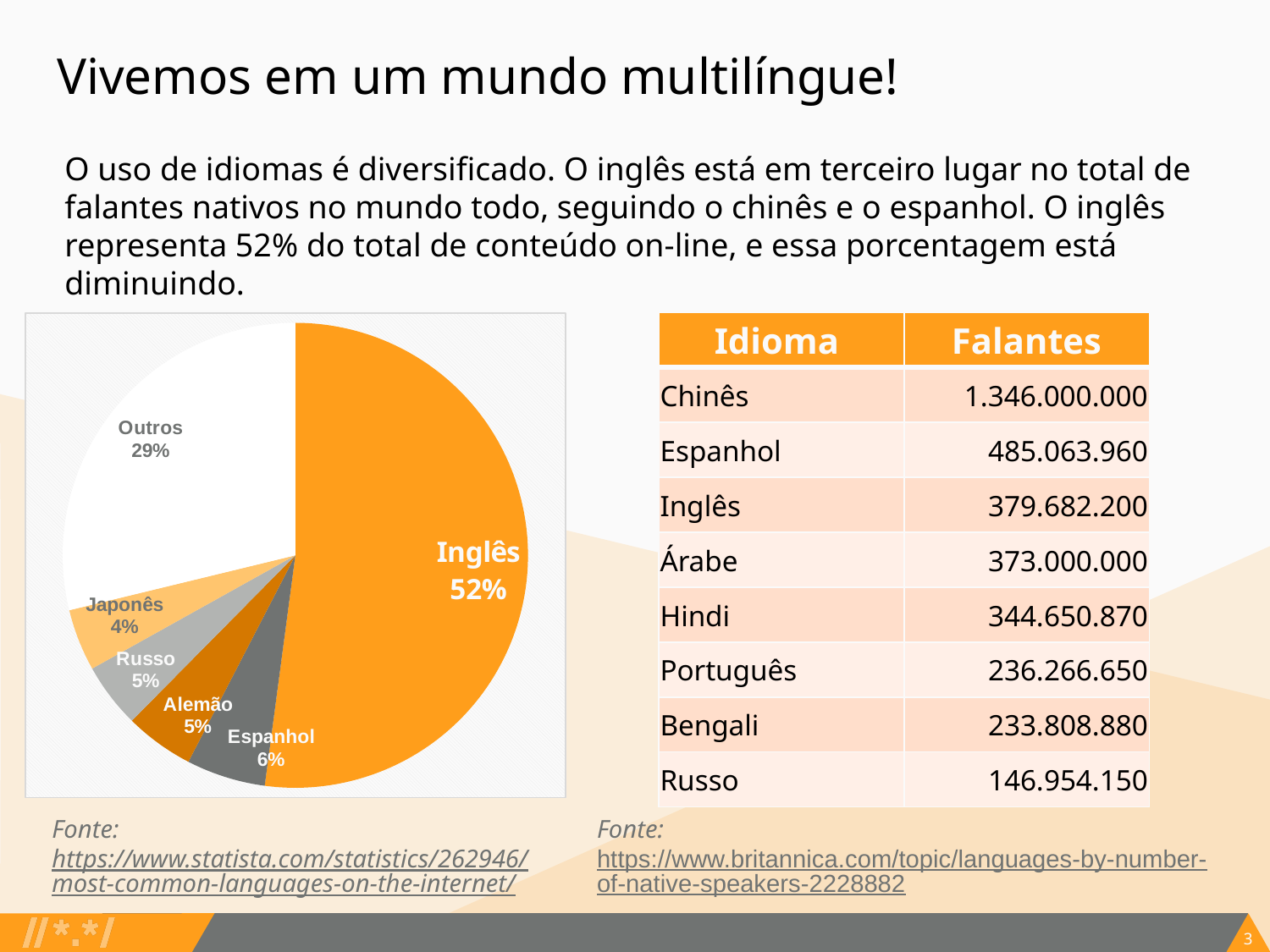
What share of the pie does Inglês represent? 52% What is the value shown for Outros in the pie chart? 29% Which slice of the pie chart is the smallest? Japonês What is the value shown for Japonês in the pie chart? 4% Which slice of the pie chart is the largest? Inglês How many slices does the pie chart have? 6 What kind of chart is shown on the slide? pie chart What is the combined share of Russo and Alemão in the pie chart? 10% What colour is the Inglês slice in the pie chart? orange Which is larger in the pie chart, Espanhol or Alemão? Espanhol What is the difference between the Inglês and Outros shares in the pie chart? 23% What is the value shown for Espanhol in the pie chart? 6%